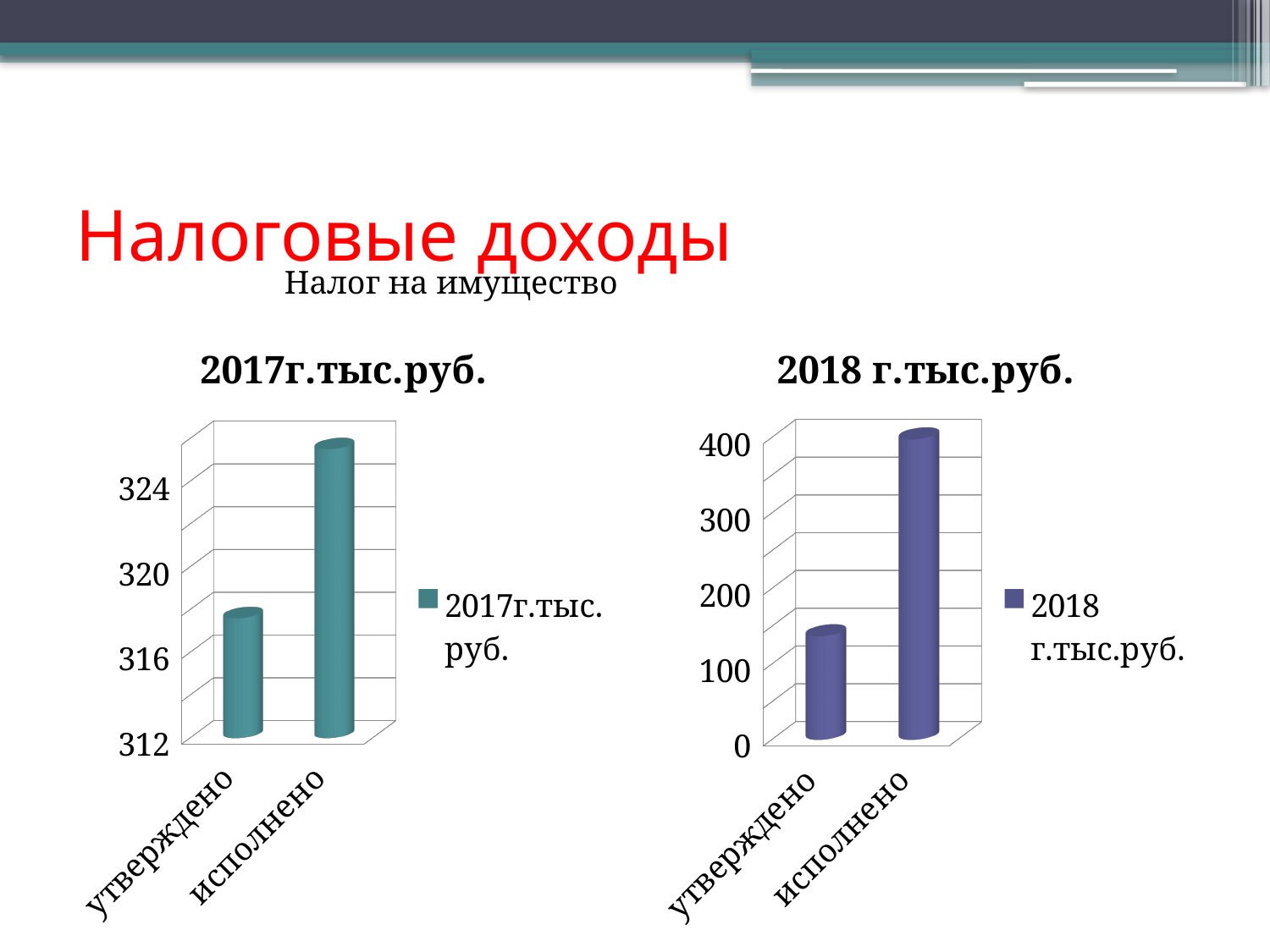
In the chart titled "2017г.тыс.руб.", which category has the higher value? исполнено In the chart titled "2018 г.тыс.руб.", is the value for исполнено greater or less than 300? greater What kind of chart is the chart titled "2017г.тыс.руб."? bar chart How many categories are shown on the x axis of the chart titled "2017г.тыс.руб."? 2 How many series does the legend of the chart titled "2018 г.тыс.руб." list? 1 In the chart titled "2017г.тыс.руб.", is the value for утверждено greater or less than 320? less What is the legend entry of the chart on the right side of the slide? 2018 г.тыс.руб. In the chart titled "2018 г.тыс.руб.", is the value for утверждено greater or less than 100? greater In the chart titled "2018 г.тыс.руб.", which category has the lower value? утверждено In the chart titled "2018 г.тыс.руб.", which is larger: утверждено or исполнено? исполнено